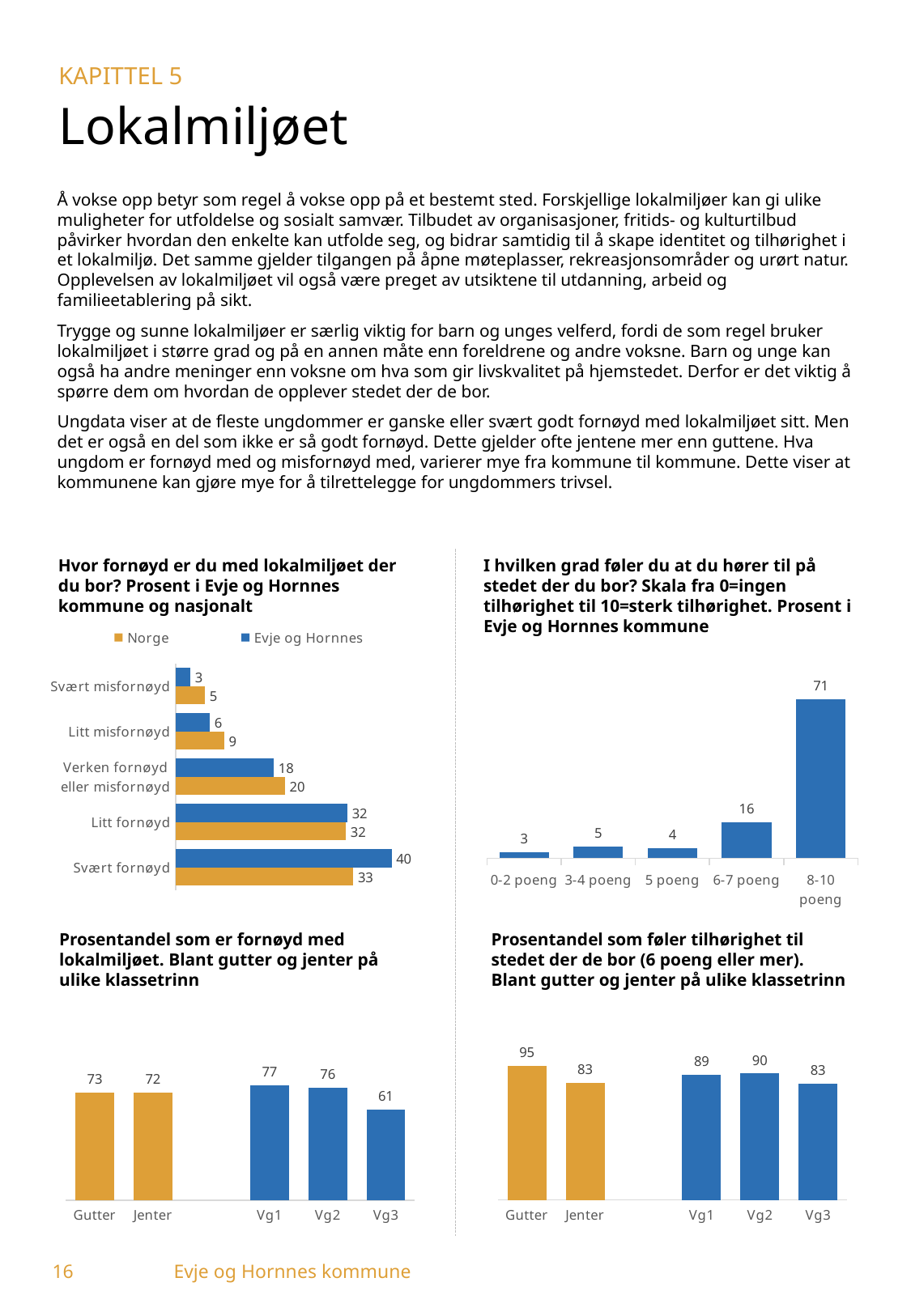
In the top-right chart 'I hvilken grad føler du at du hører til på stedet der du bor?', what is the value for '6-7 poeng'? 16 In the top-left chart 'Hvor fornøyd er du med lokalmiljøet der du bor?', what is the value for Evje og Hornnes in the 'Svært fornøyd' category? 40 In the top-left chart 'Hvor fornøyd er du med lokalmiljøet der du bor?', what is the difference between Evje og Hornnes and Norge for 'Svært fornøyd'? 7 In the bottom-left chart 'Prosentandel som er fornøyd med lokalmiljøet', which category has the lowest value? Vg3 In the bottom-right chart 'Prosentandel som føler tilhørighet til stedet der de bor', what is the difference between Gutter and Jenter? 12 What kind of chart is the top-left chart 'Hvor fornøyd er du med lokalmiljøet der du bor?'? Bar chart In the top-left chart 'Hvor fornøyd er du med lokalmiljøet der du bor?', what is the value for Norge in the 'Litt misfornøyd' category? 9 In the top-right chart 'I hvilken grad føler du at du hører til på stedet der du bor?', which category has the highest value? 8-10 poeng In the top-right chart 'I hvilken grad føler du at du hører til på stedet der du bor?', how many categories are shown on the x axis? 5 In the top-left chart 'Hvor fornøyd er du med lokalmiljøet der du bor?', how many series does the legend list? 2 In the bottom-right chart 'Prosentandel som føler tilhørighet til stedet der de bor', which is larger, Gutter or Jenter? Gutter In the bottom-left chart 'Prosentandel som er fornøyd med lokalmiljøet', what is the value for Gutter? 73